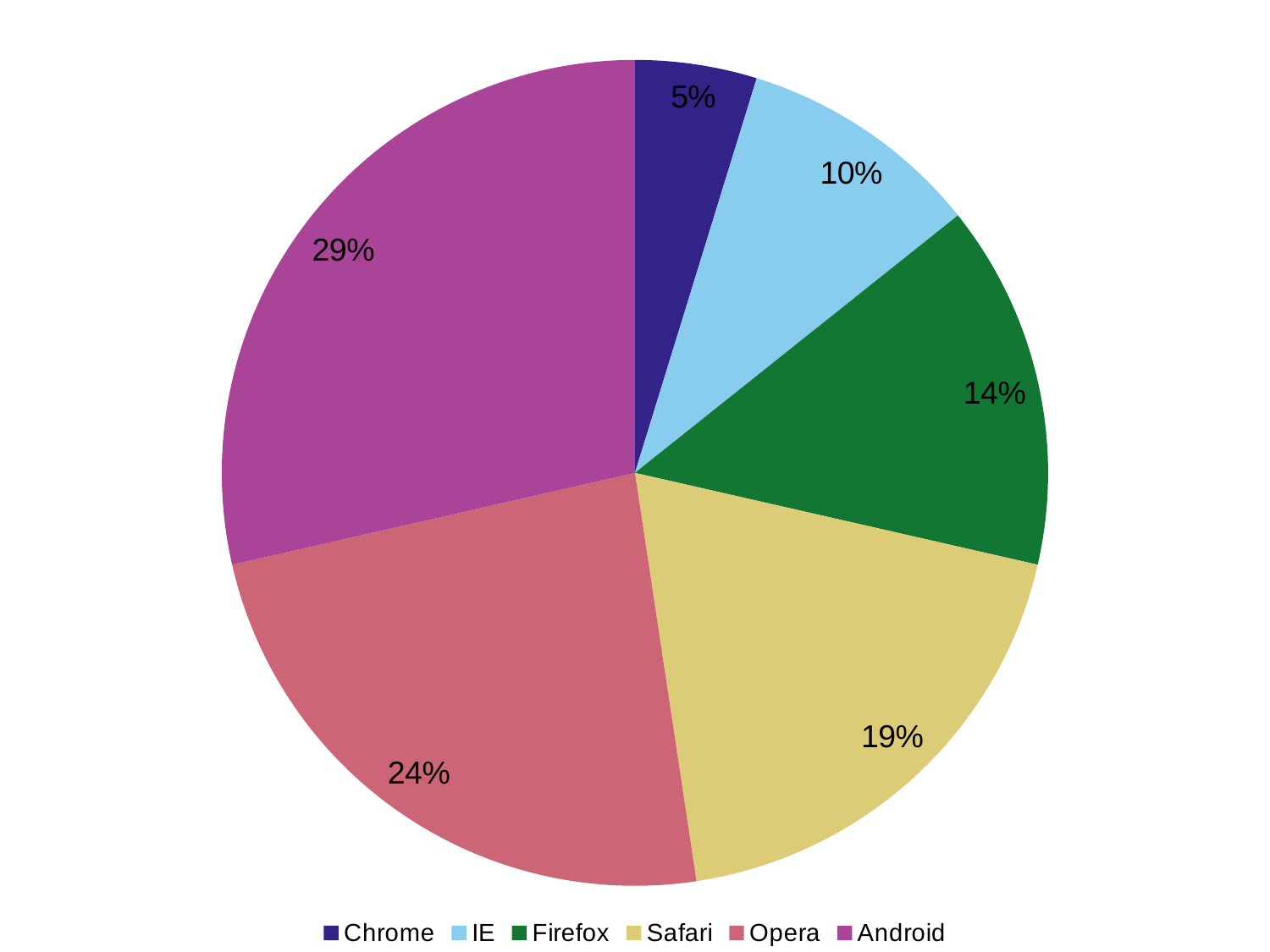
What kind of chart is shown on the slide? Pie chart What is the difference between the Opera and IE shares? 14% Which is larger, the Safari slice or the Firefox slice? Safari What share of the pie does Android have? 29% What colour is the Opera slice? Red (pinkish red) What is the combined share of Chrome and IE? 15% Which category has the largest slice of the pie? Android Which category has the smallest slice of the pie? Chrome How many categories are shown in the pie chart? 6 What share of the pie does Chrome have? 5% What is the value shown for Firefox? 14% What is the value shown for Safari? 19%